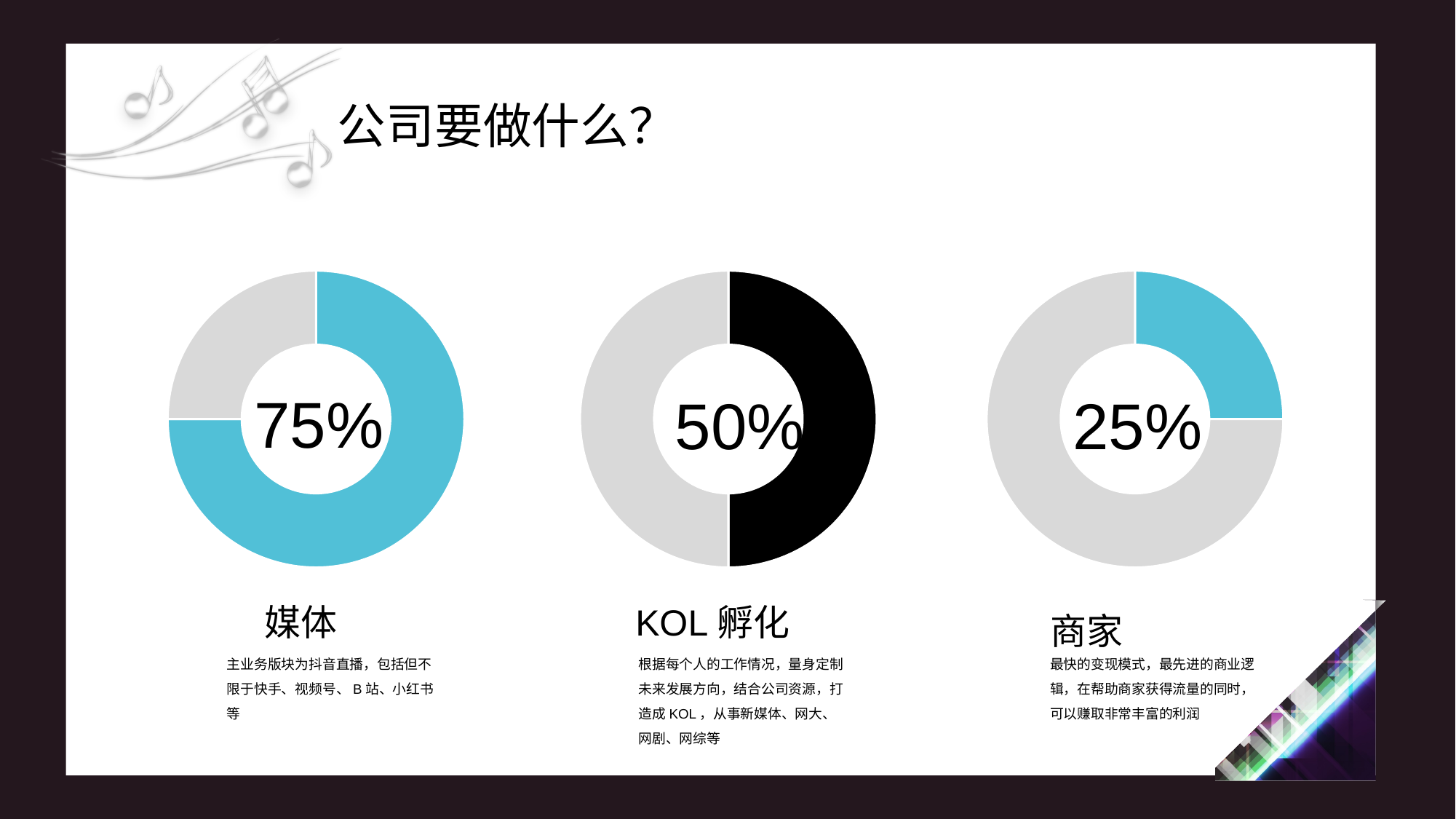
What is the difference between the percentage shown for 媒体 and the percentage shown for 商家? 50% What kind of chart is used for 媒体, KOL 孵化 and 商家? Donut (pie) chart Which of the three donut charts shows the highest percentage? 媒体 How many donut charts are on the slide? 3 What is the difference between the percentage shown for KOL 孵化 and the percentage shown for 商家? 25% What percentage is shown in the centre of the 商家 donut chart? 25% What is the title of the slide containing the three donut charts? 公司要做什么? What percentage is shown in the centre of the KOL 孵化 donut chart? 50% Which of the three donut charts shows the lowest percentage? 商家 Which shows a larger percentage, the KOL 孵化 chart or the 商家 chart? KOL 孵化 What colour is the filled portion of the KOL 孵化 donut chart? Black What percentage is shown in the centre of the 媒体 donut chart? 75%